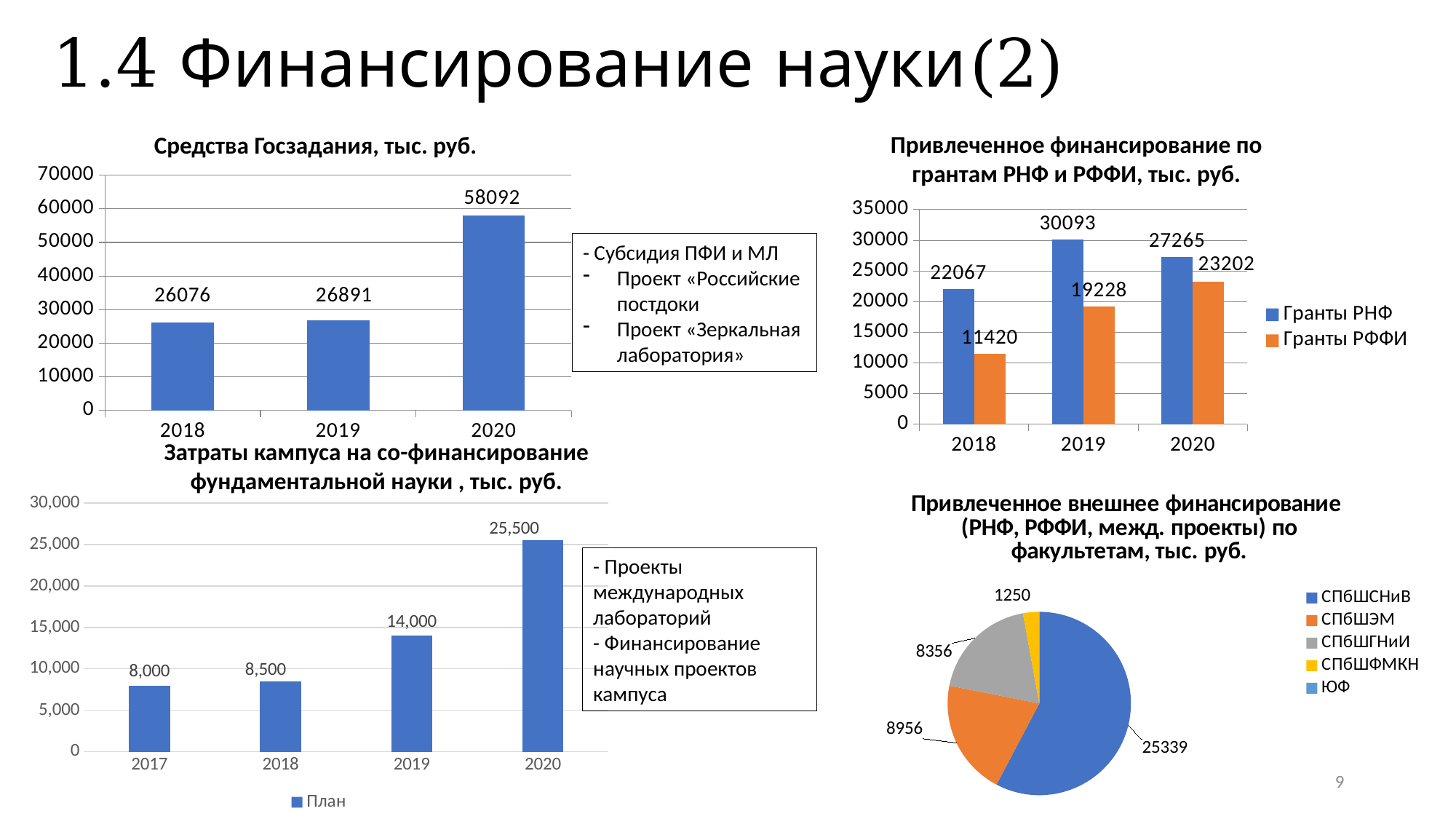
In the chart 'Затраты кампуса на со-финансирование фундаментальной науки, тыс. руб.', what is the difference between the 2020 and 2019 values? 11,500 In the pie chart 'Привлеченное внешнее финансирование (РНФ, РФФИ, межд. проекты) по факультетам, тыс. руб.', which faculty has the largest slice? СПбШСНиВ What kind of chart is 'Привлеченное внешнее финансирование (РНФ, РФФИ, межд. проекты) по факультетам, тыс. руб.'? pie chart In the chart 'Средства Госзадания, тыс. руб.', what is the value for 2020? 58092 In the chart 'Привлеченное финансирование по грантам РНФ и РФФИ, тыс. руб.', how many series does the legend list? 2 In the chart 'Затраты кампуса на со-финансирование фундаментальной науки, тыс. руб.', what is the value for 2018? 8,500 In the chart 'Средства Госзадания, тыс. руб.', which year has the lowest value? 2018 In the chart 'Привлеченное финансирование по грантам РНФ и РФФИ, тыс. руб.', which year has the highest value for Гранты РНФ? 2019 In the chart 'Привлеченное финансирование по грантам РНФ и РФФИ, тыс. руб.', what is the value of Гранты РФФИ for 2019? 19228 In the chart 'Средства Госзадания, тыс. руб.', what is the difference between the 2020 and 2019 values? 31201 In the chart 'Затраты кампуса на со-финансирование фундаментальной науки, тыс. руб.', how many years are shown on the x axis? 4 In the chart 'Привлеченное финансирование по грантам РНФ и РФФИ, тыс. руб.', do the values for Гранты РФФИ rise or fall from 2018 to 2020? rise